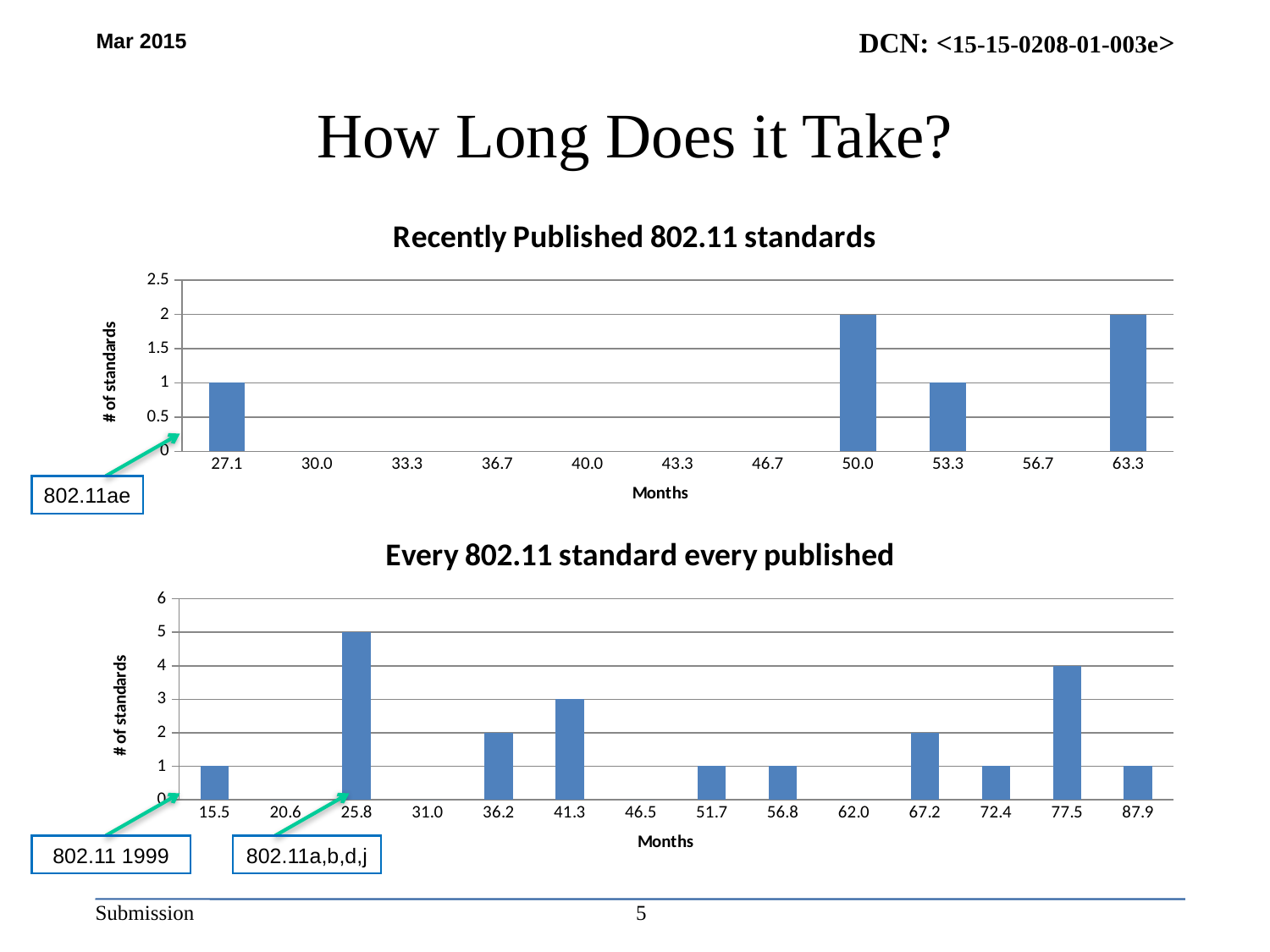
In the 'Recently Published 802.11 standards' chart, which standard is labelled by the callout pointing at the 27.1 months bar? 802.11ae In the 'Recently Published 802.11 standards' chart, what is the value for 53.3 months? 1 In the 'Every 802.11 standard every published' chart, what is the value for 41.3 months? 3 In the 'Every 802.11 standard every published' chart, what is the value for 77.5 months? 4 What kind of chart is the 'Every 802.11 standard every published' chart? Bar chart In the 'Recently Published 802.11 standards' chart, how many categories are shown on the x axis? 11 In the 'Every 802.11 standard every published' chart, what is the difference between the values for 25.8 months and 77.5 months? 1 In the 'Recently Published 802.11 standards' chart, what is the value for 50.0 months? 2 In the 'Every 802.11 standard every published' chart, which is larger, the value for 36.2 months or the value for 41.3 months? 41.3 In the 'Every 802.11 standard every published' chart, how many categories are shown on the x axis? 14 In the 'Every 802.11 standard every published' chart, which standards does the callout pointing at the 25.8 months bar name? 802.11a,b,d,j In the 'Every 802.11 standard every published' chart, which months category has the highest number of standards? 25.8